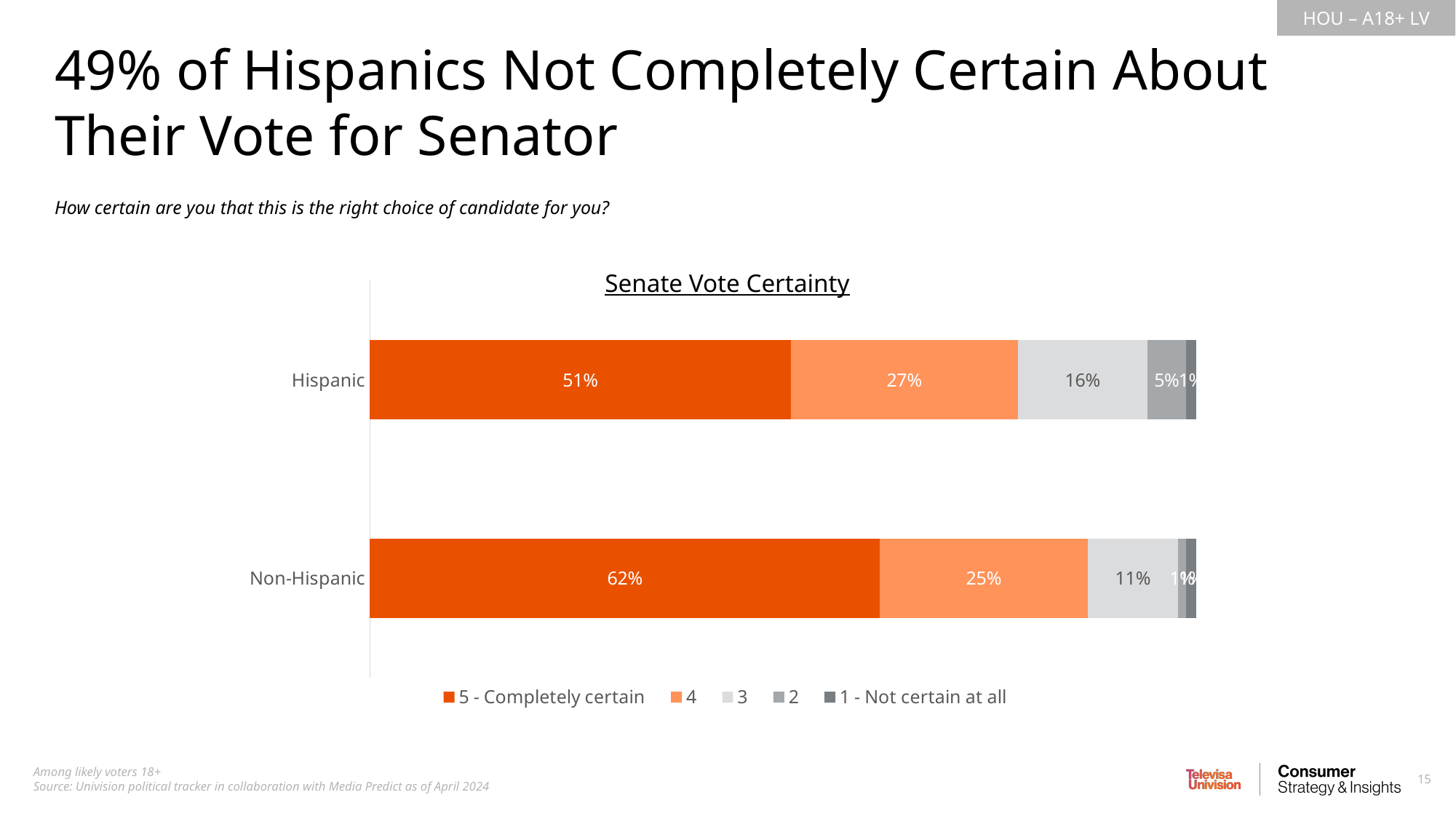
How many series does the legend list? 5 What type of chart is used to show Senate Vote Certainty? Stacked bar chart What is the value of the '3' segment for Non-Hispanic voters? 11% What is the value of the '2' segment for Hispanic voters? 5% What is the value of the '4' segment for Non-Hispanic voters? 25% What is the difference in percentage points between Non-Hispanic and Hispanic voters who are '5 - Completely certain'? 11 percentage points What percentage of Non-Hispanic likely voters are '5 - Completely certain' about their Senate vote? 62% Which group has the larger share of '5 - Completely certain' voters, Hispanic or Non-Hispanic? Non-Hispanic What is the difference in percentage points between the '3' segment for Hispanic voters and for Non-Hispanic voters? 5 percentage points What is the value of the '4' segment for Hispanic voters? 27% What percentage of Hispanic likely voters are '5 - Completely certain' about their Senate vote? 51% How many groups (bars) are shown in the chart? 2